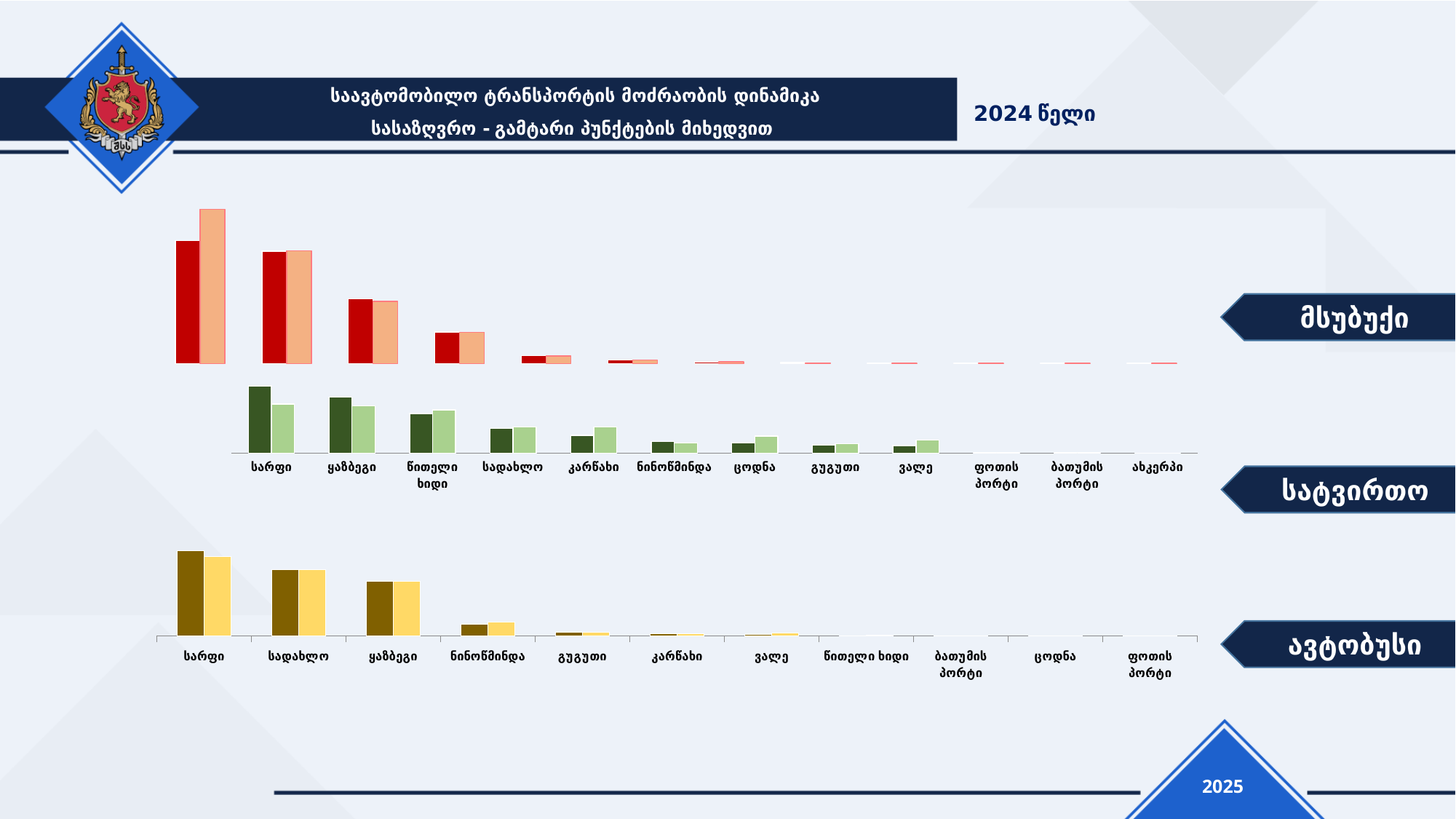
Which year is shown in the header next to the slide title? 2024 წელი In the სატვირთო chart, which category has the highest bars? სარფი What kind of chart is the ავტობუსი chart? bar chart In the ავტობუსი chart, which is larger, the value for სარფი or the value for ნინოწმინდა? სარფი What is the label of the top chart on the slide, shown in the arrow on the right? მსუბუქი What kind of chart is the სატვირთო chart? bar chart How many categories are shown on the x axis of the სატვირთო chart? 12 In the სატვირთო chart, do the values generally rise or fall from left to right along the x axis? fall In the სატვირთო chart, which is larger, the value for ყაზბეგი or the value for ვალე? ყაზბეგი How many categories are shown on the x axis of the ავტობუსი chart? 11 In the ავტობუსი chart, which category has the highest bars? სარფი In the ავტობუსი chart, do the values generally rise or fall from left to right along the x axis? fall